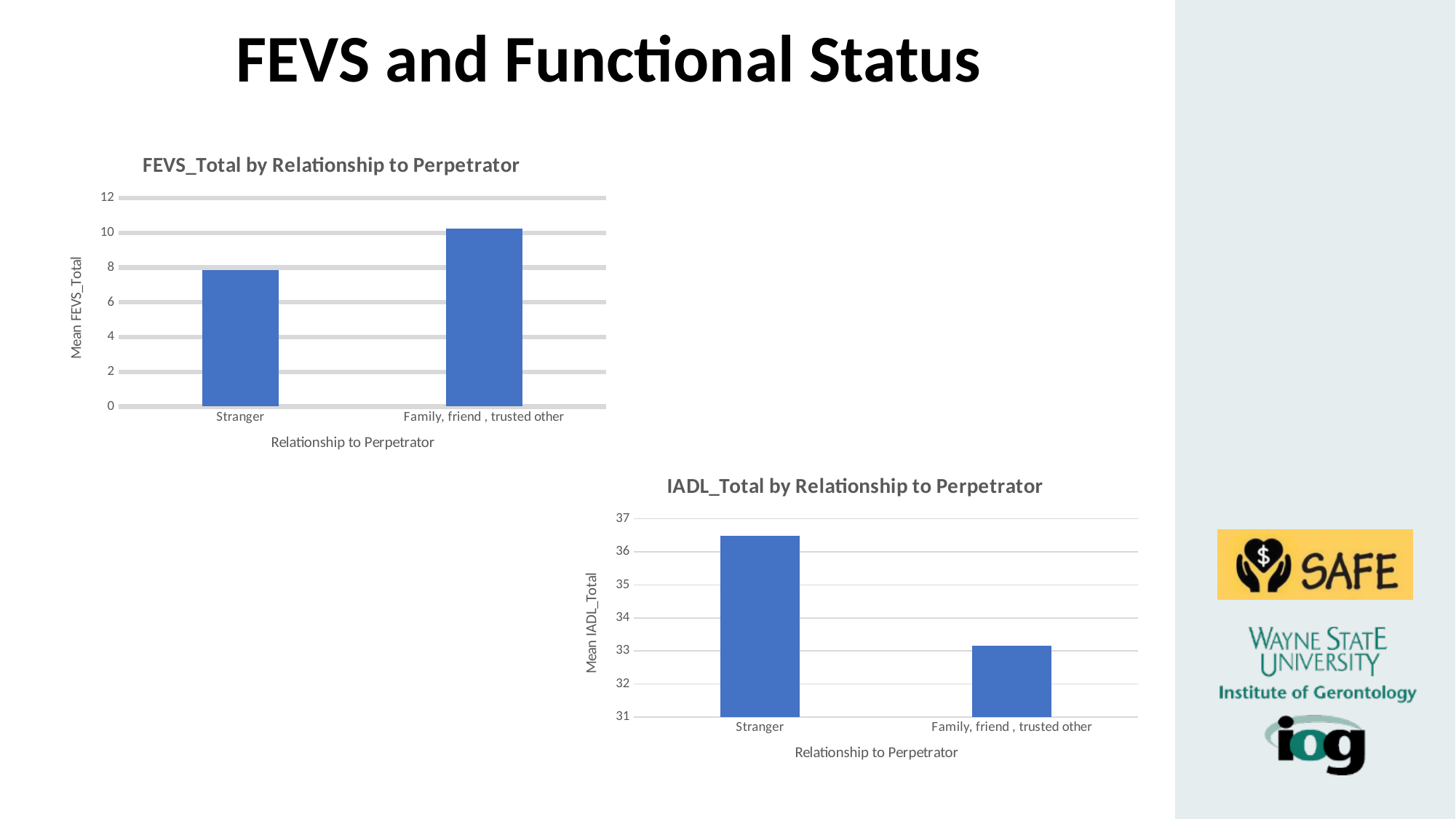
In the 'FEVS_Total by Relationship to Perpetrator' chart, is the value for Family, friend, trusted other greater or less than 10? greater What kind of chart is 'FEVS_Total by Relationship to Perpetrator'? Bar chart In the 'IADL_Total by Relationship to Perpetrator' chart, is the value for Stranger greater or less than 36? greater In the 'IADL_Total by Relationship to Perpetrator' chart, which is larger: the value for Stranger or the value for Family, friend, trusted other? Stranger In the 'FEVS_Total by Relationship to Perpetrator' chart, how many categories are shown on the x axis? 2 In the 'IADL_Total by Relationship to Perpetrator' chart, is the value for Family, friend, trusted other greater or less than 34? less In the 'FEVS_Total by Relationship to Perpetrator' chart, which category has the highest mean FEVS_Total? Family, friend , trusted other In the 'IADL_Total by Relationship to Perpetrator' chart, which category has the lowest mean IADL_Total? Family, friend , trusted other In the 'IADL_Total by Relationship to Perpetrator' chart, which category has the highest mean IADL_Total? Stranger What is the y-axis label of the 'IADL_Total by Relationship to Perpetrator' chart? Mean IADL_Total In the 'FEVS_Total by Relationship to Perpetrator' chart, which category has the lowest mean FEVS_Total? Stranger